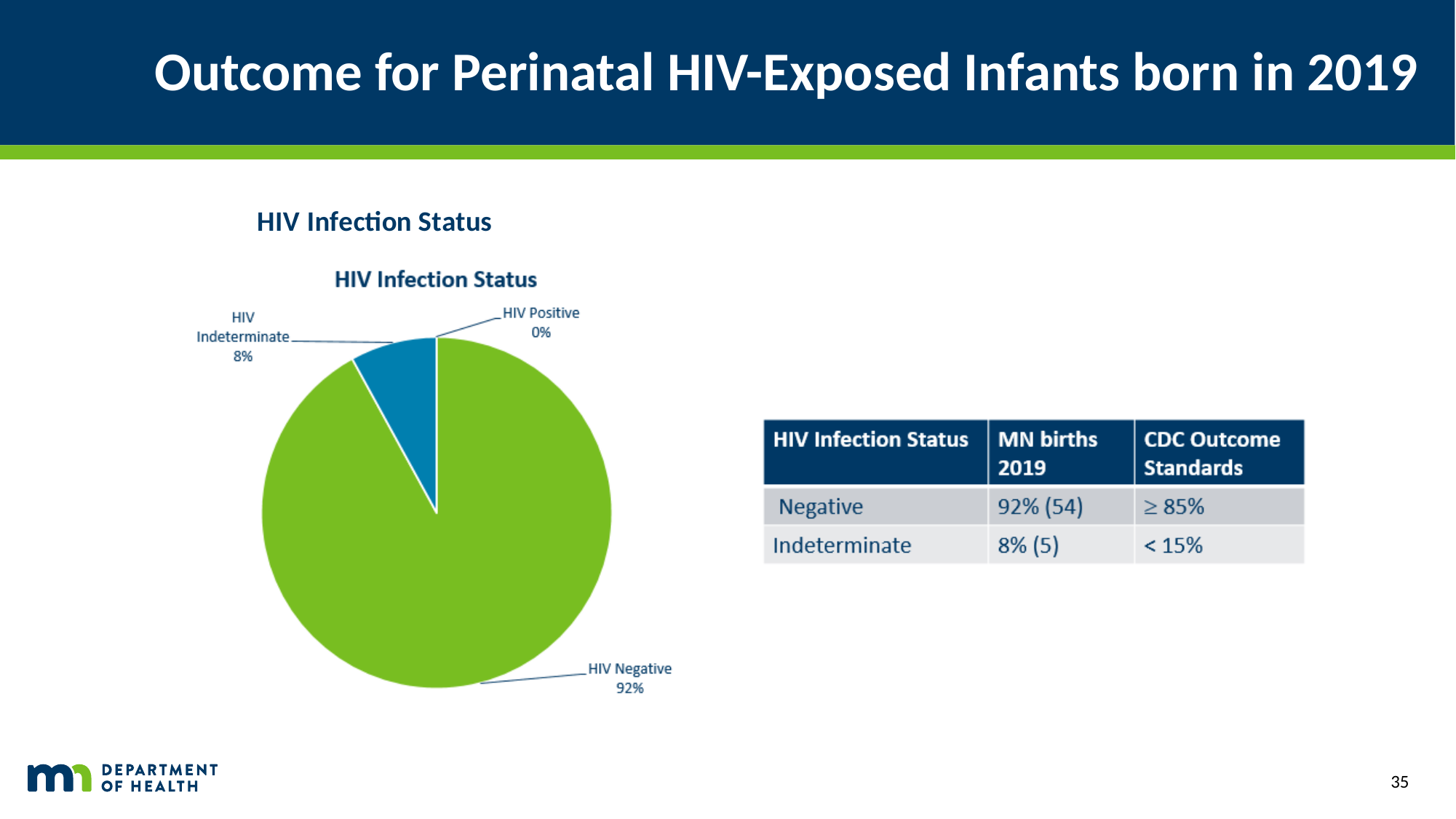
Which is larger, the HIV Indeterminate share or the HIV Positive share? HIV Indeterminate What is the combined share of HIV Negative and HIV Indeterminate? 100% What colour is the HIV Negative slice? Green What is the difference in percentage points between HIV Negative and HIV Indeterminate? 84% What is the title of the chart? HIV Infection Status Which category has the smallest share of the pie? HIV Positive What percentage of the pie is HIV Negative? 92% What percentage of the pie is HIV Indeterminate? 8% How many categories are labelled on the pie chart? 3 What percentage of the pie is HIV Positive? 0% Which category has the largest share of the pie? HIV Negative What kind of chart is shown on the slide? Pie chart